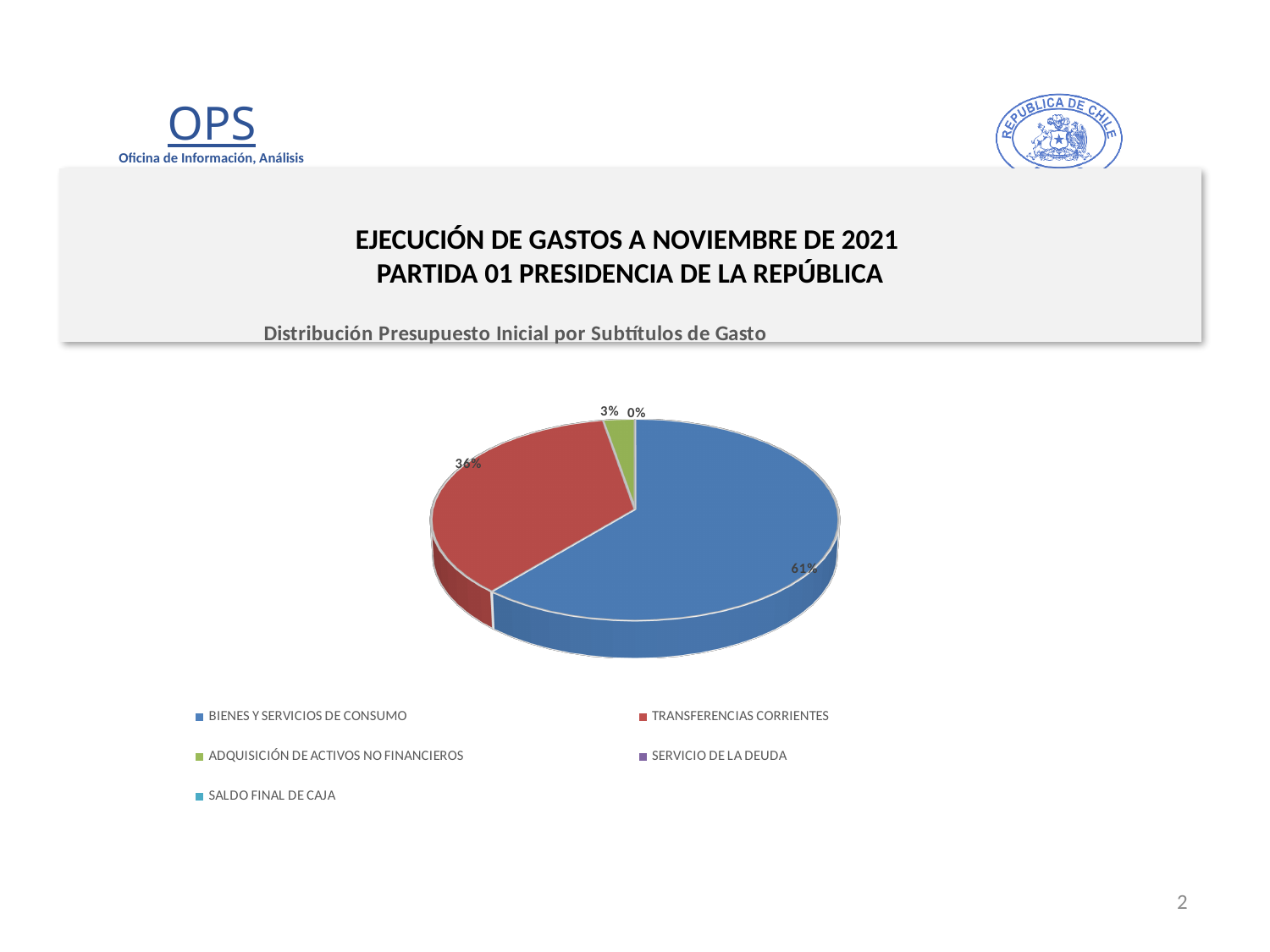
What share of the pie does TRANSFERENCIAS CORRIENTES represent? 36% What percentage is shown for SERVICIO DE LA DEUDA? 0% Which is larger, the share for TRANSFERENCIAS CORRIENTES or the share for ADQUISICIÓN DE ACTIVOS NO FINANCIEROS? TRANSFERENCIAS CORRIENTES What is the title of the chart? Distribución Presupuesto Inicial por Subtítulos de Gasto By how many percentage points does the share of BIENES Y SERVICIOS DE CONSUMO exceed that of TRANSFERENCIAS CORRIENTES? 25 percentage points Which category has the largest slice of the pie? BIENES Y SERVICIOS DE CONSUMO What share of the pie does ADQUISICIÓN DE ACTIVOS NO FINANCIEROS represent? 3% What share of the pie does BIENES Y SERVICIOS DE CONSUMO represent? 61% How many categories are listed in the chart's legend? 5 What kind of chart is shown on the slide? pie chart What colour is the slice for TRANSFERENCIAS CORRIENTES? red